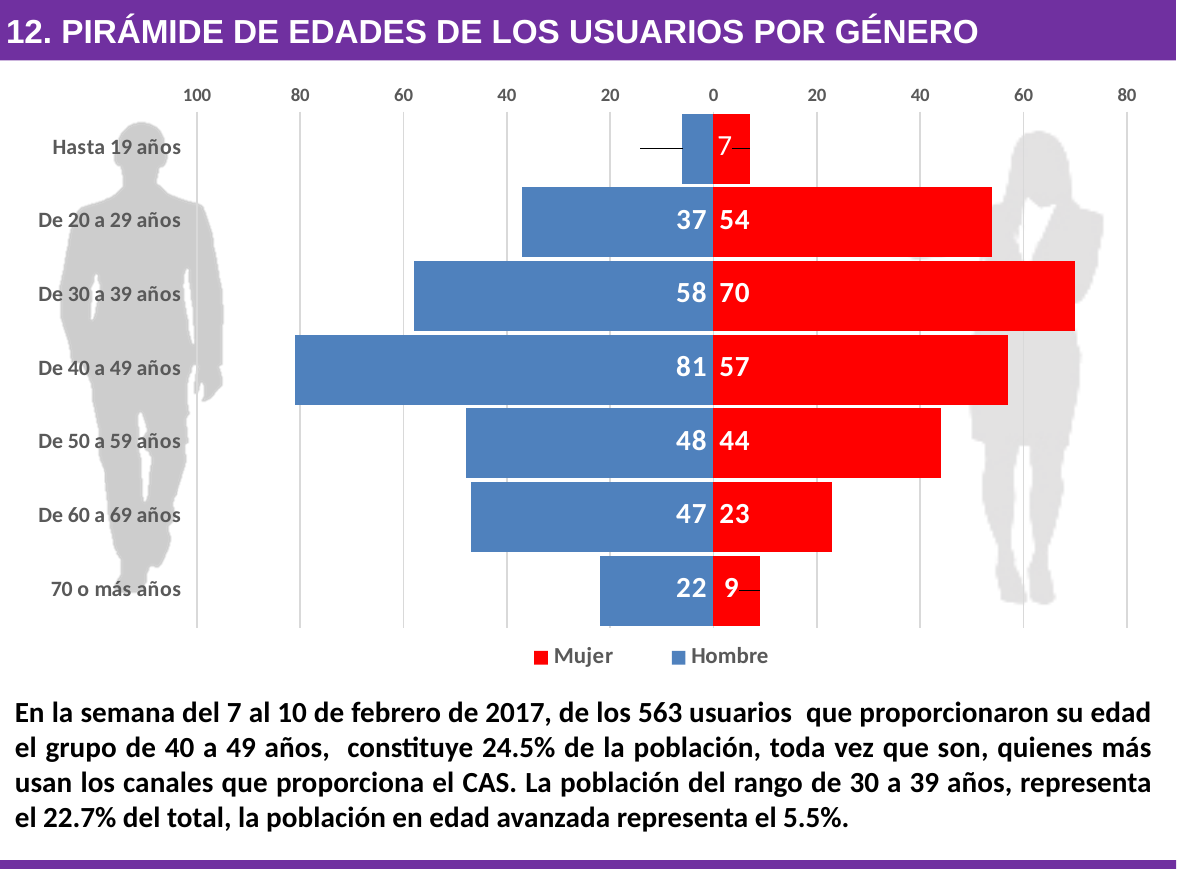
What is the combined total of Hombre and Mujer in the 'De 40 a 49 años' group? 138 How many series does the legend list? 2 Is the Hombre value for 'Hasta 19 años' greater or less than 20? less Which age group has the lowest value for Mujer? Hasta 19 años What is the difference between the Mujer and Hombre values in the 'De 30 a 39 años' group? 12 What kind of chart is shown on the slide? bar chart Which age group has the highest value for Hombre? De 40 a 49 años What is the value for Hombre in the 'De 40 a 49 años' age group? 81 In the 'De 50 a 59 años' group, which is larger, Hombre or Mujer? Hombre How many age groups are shown in the chart? 7 What is the value for Mujer in the 'De 20 a 29 años' age group? 54 Which age group has the highest value for Mujer? De 30 a 39 años